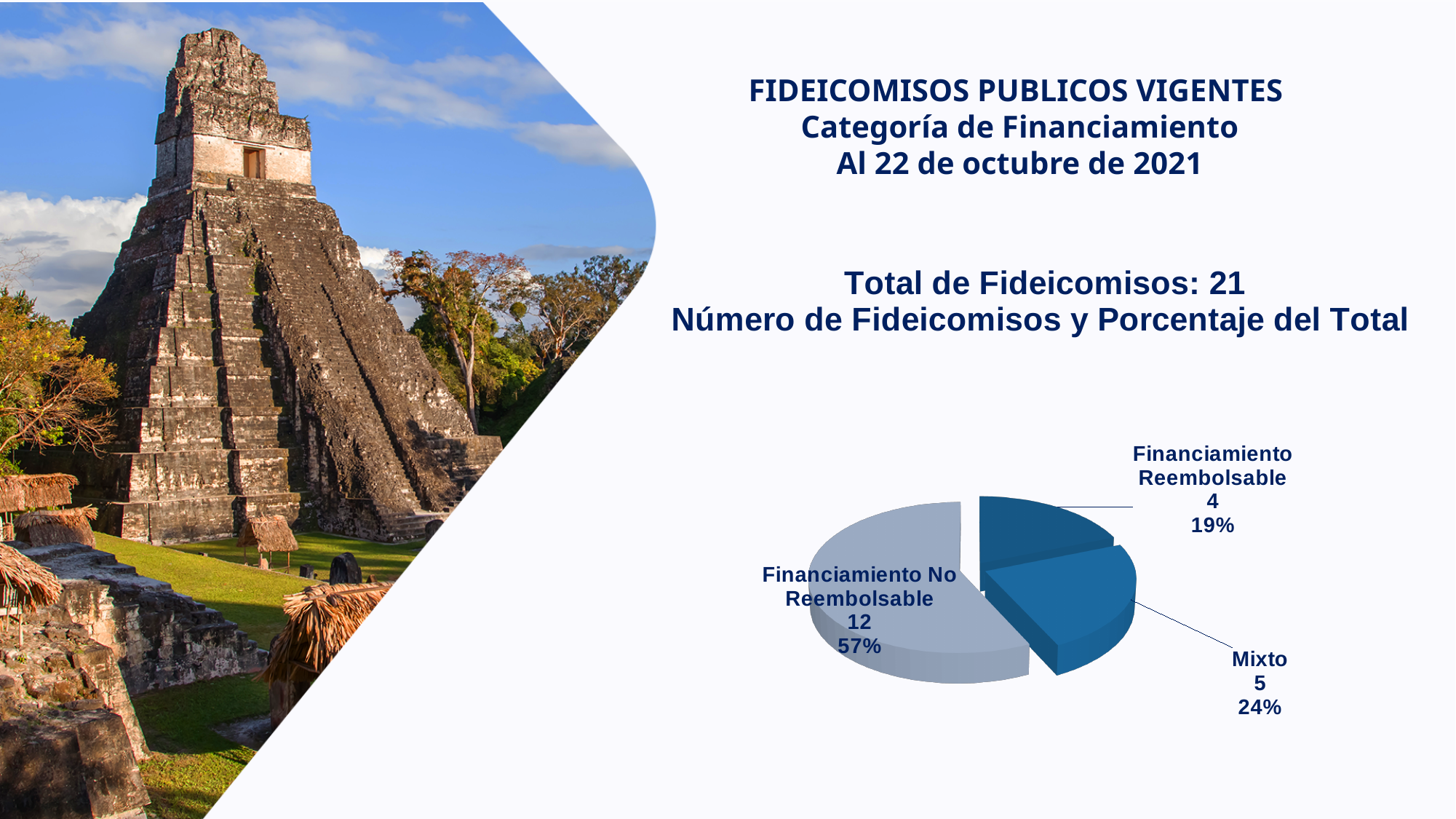
What kind of chart is shown on the slide? Pie chart What is the difference in the number of fideicomisos between Financiamiento No Reembolsable and Mixto? 7 How many fideicomisos are in the Mixto category? 5 What percentage of the total does the Mixto slice represent? 24% What percentage of the total does the Financiamiento Reembolsable slice represent? 19% Which has more fideicomisos, Mixto or Financiamiento Reembolsable? Mixto How many categories does the pie chart show? 3 How many fideicomisos are in the Financiamiento Reembolsable category? 4 How many fideicomisos are in the Financiamiento No Reembolsable category? 12 What percentage of the total does the Financiamiento No Reembolsable slice represent? 57% Which category has the smallest number of fideicomisos? Financiamiento Reembolsable Which category has the largest number of fideicomisos? Financiamiento No Reembolsable